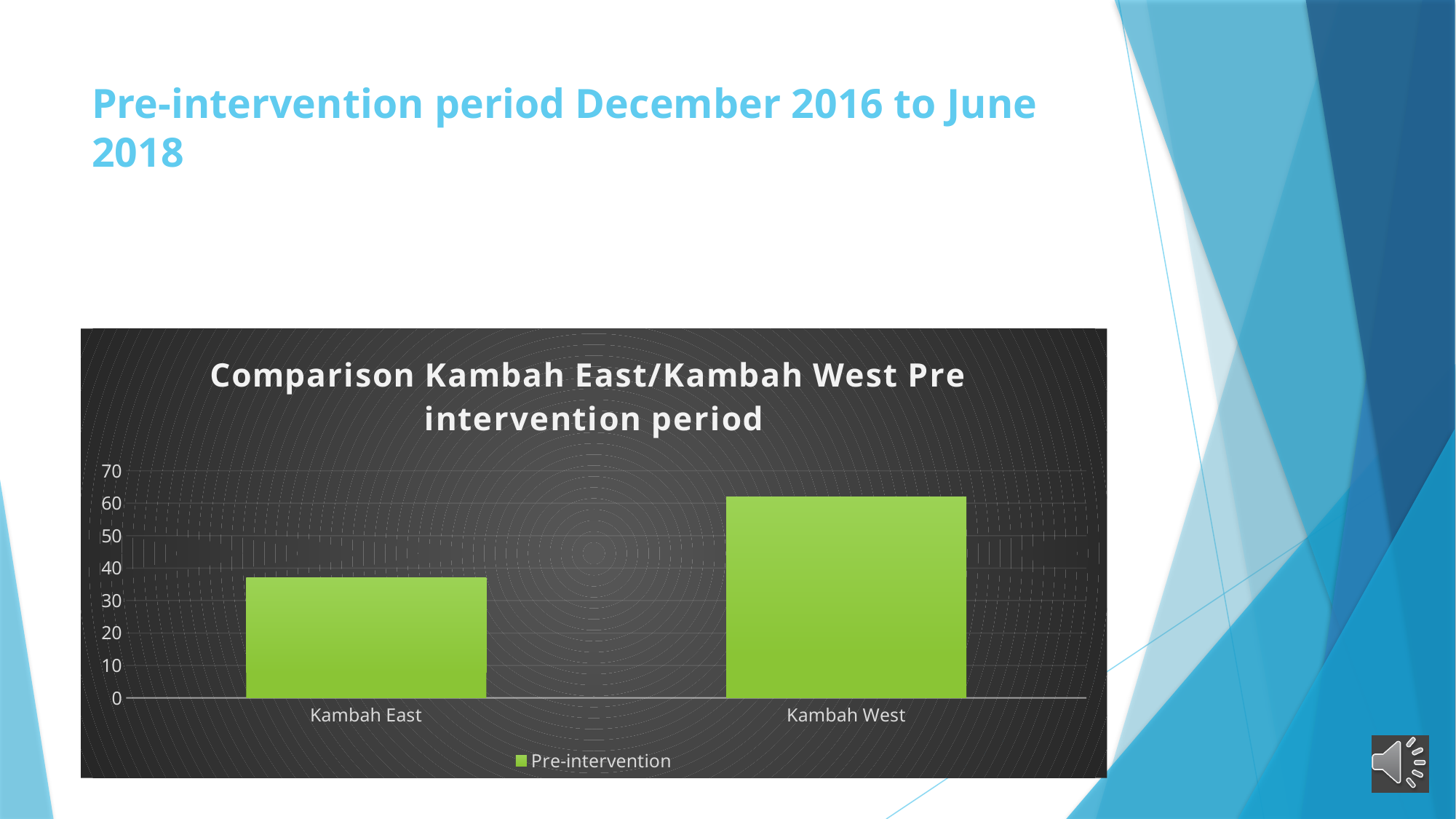
Which category has the highest value? Kambah West How many categories are shown on the x axis of the chart? 2 Is the value for Kambah East greater or less than 40? less What is the title of the chart? Comparison Kambah East/Kambah West Pre intervention period Which category has the lowest value? Kambah East What kind of chart is shown on the slide? bar chart Is the value for Kambah West greater or less than 70? less Which is larger, the value for Kambah East or the value for Kambah West? Kambah West What is the name of the series shown in the legend? Pre-intervention Is the value for Kambah East greater or less than 30? greater How many series does the chart legend list? 1